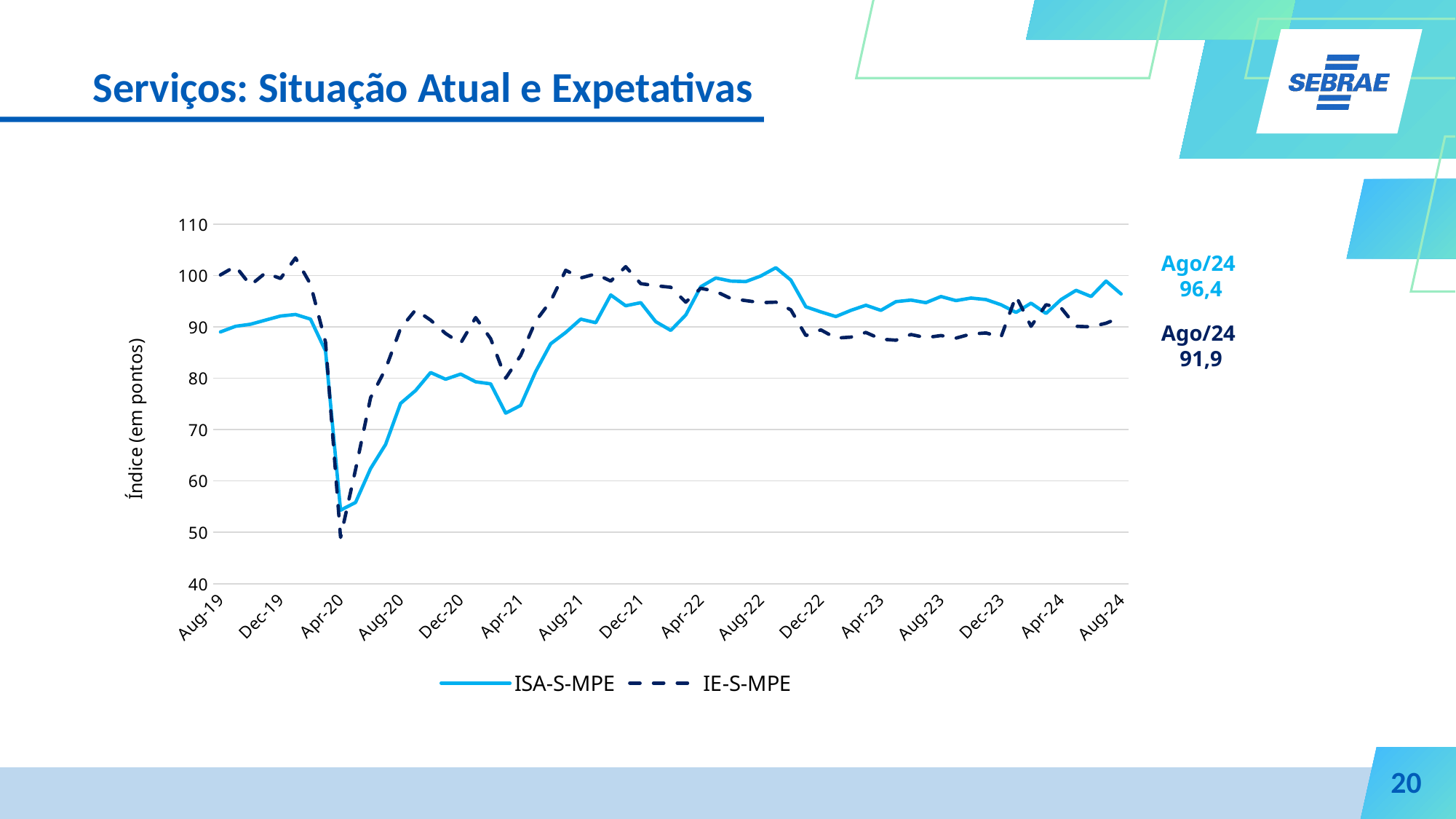
Which series has the higher value in Ago/24, ISA-S-MPE or IE-S-MPE? ISA-S-MPE What is the label on the vertical axis of the chart? Índice (em pontos) How many series does the legend list? 2 Which series reaches the lowest point on the chart around Apr-20? IE-S-MPE What is the value of IE-S-MPE in Ago/24? 91,9 Is the value for ISA-S-MPE at Apr-21 greater or less than 80? less Is the value for IE-S-MPE at Apr-23 greater or less than 90? less Does the ISA-S-MPE line rise or fall between Apr-20 and Aug-21? rise Is the value for ISA-S-MPE at Apr-20 greater or less than 60? less What kind of chart is shown on the slide? line chart What is the value of ISA-S-MPE in Ago/24? 96,4 What is the difference between ISA-S-MPE and IE-S-MPE in Ago/24? 4,5